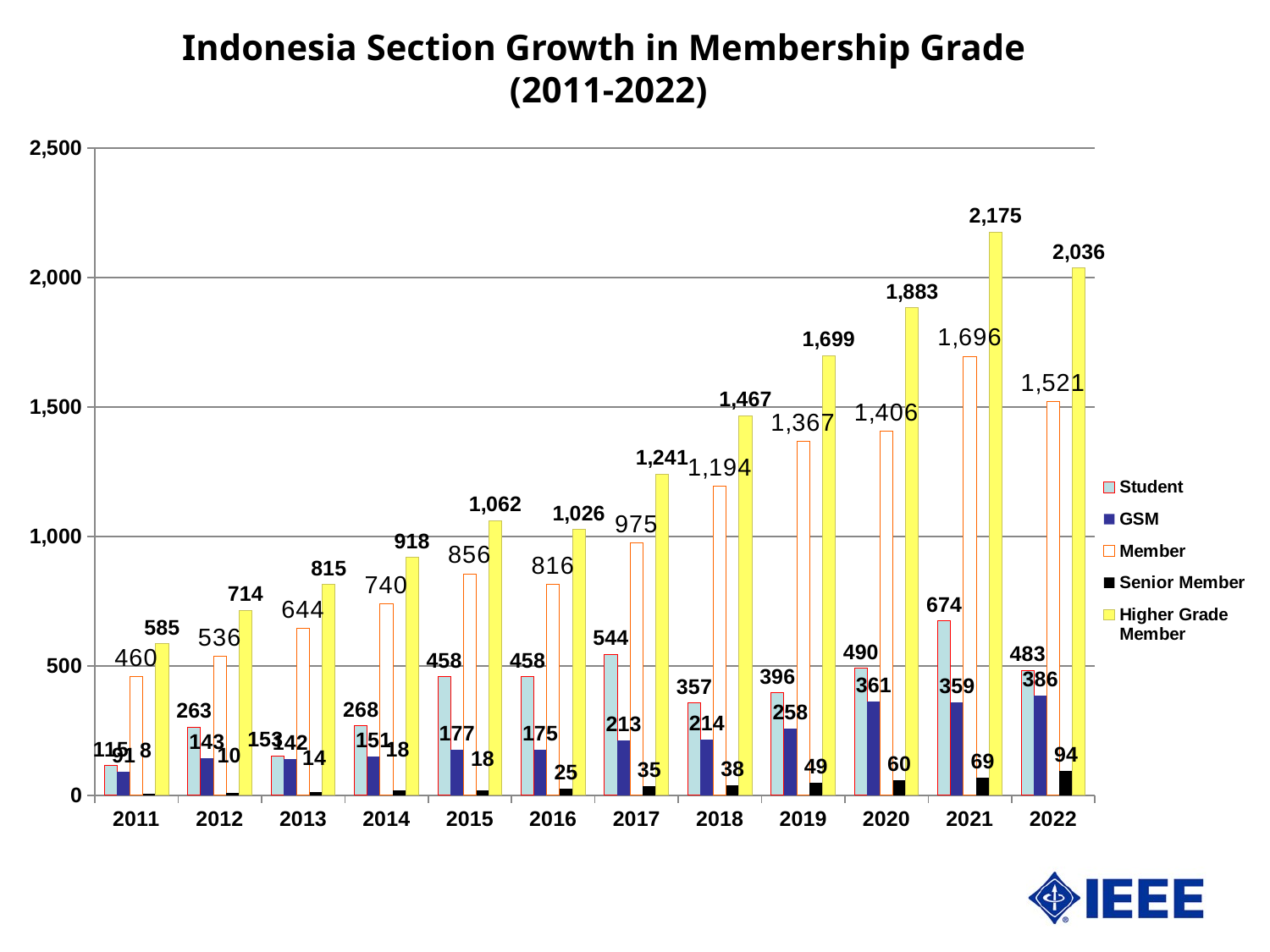
How many series does the legend list? 5 What is the Member value for 2019? 1,367 How many years are shown on the x axis? 12 What is the Higher Grade Member value for 2021? 2,175 Which is larger, the Student value for 2020 or the Student value for 2022? 2020 What is the Student value for 2017? 544 Is the Member value for 2018 greater or less than 1,000? greater What is the Senior Member value for 2022? 94 What is the difference between the Higher Grade Member values for 2021 and 2022? 139 What kind of chart is shown on the slide? Bar chart In which year is the Member value lowest? 2011 In which year is the Higher Grade Member value highest? 2021